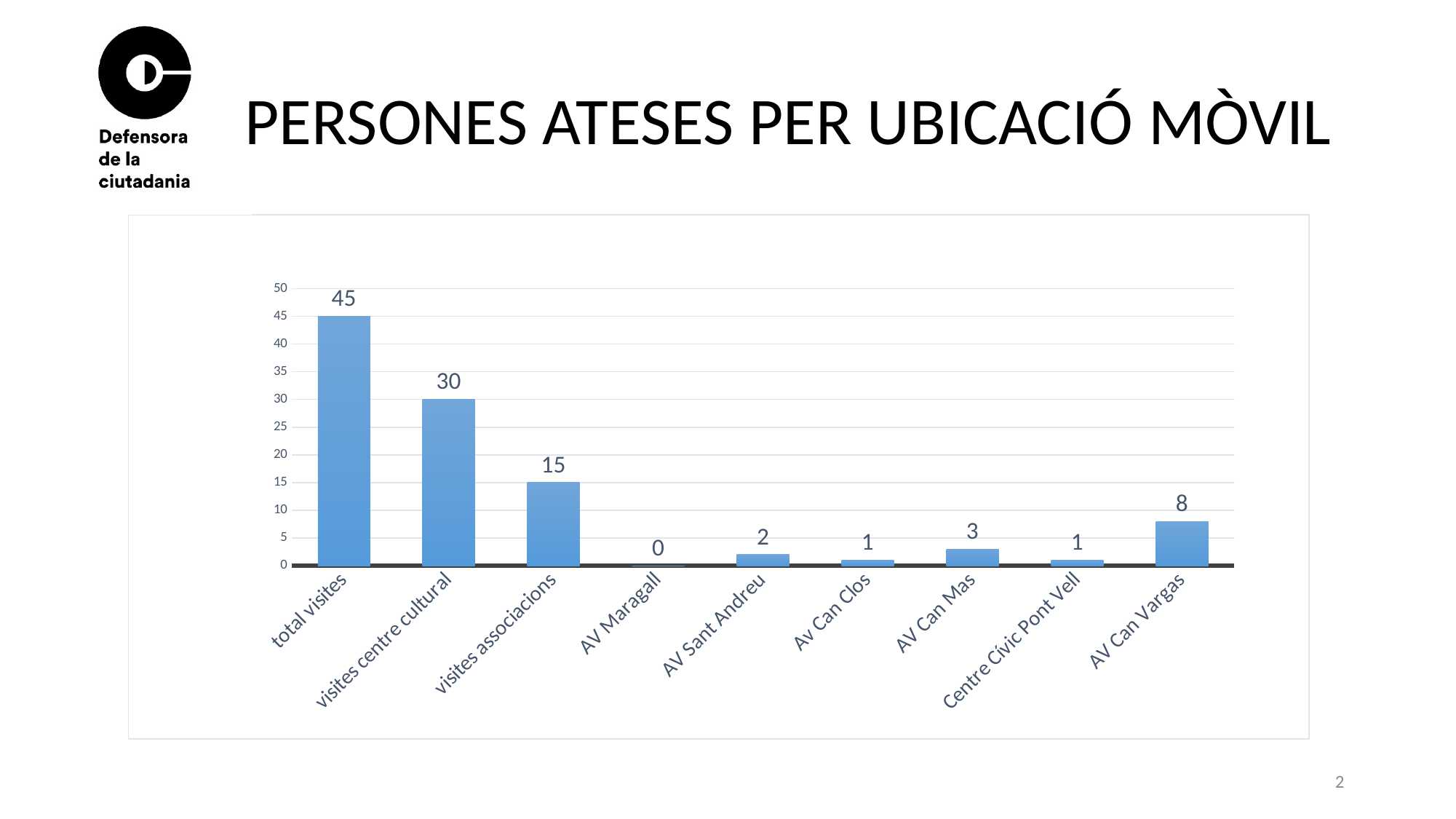
Which category has the lowest value? AV Maragall How many categories are shown on the x axis? 9 Which category has the highest value? total visites What is the value for AV Can Vargas? 8 What is the value for AV Can Mas? 3 What is the value for AV Maragall? 0 What kind of chart is shown on the slide? bar chart What is the value for visites centre cultural? 30 Which is larger, AV Can Vargas or AV Can Mas? AV Can Vargas Is the value for total visites greater or less than 40? greater What is the difference between visites centre cultural and visites associacions? 15 What is the title of the slide? PERSONES ATESES PER UBICACIÓ MÒVIL